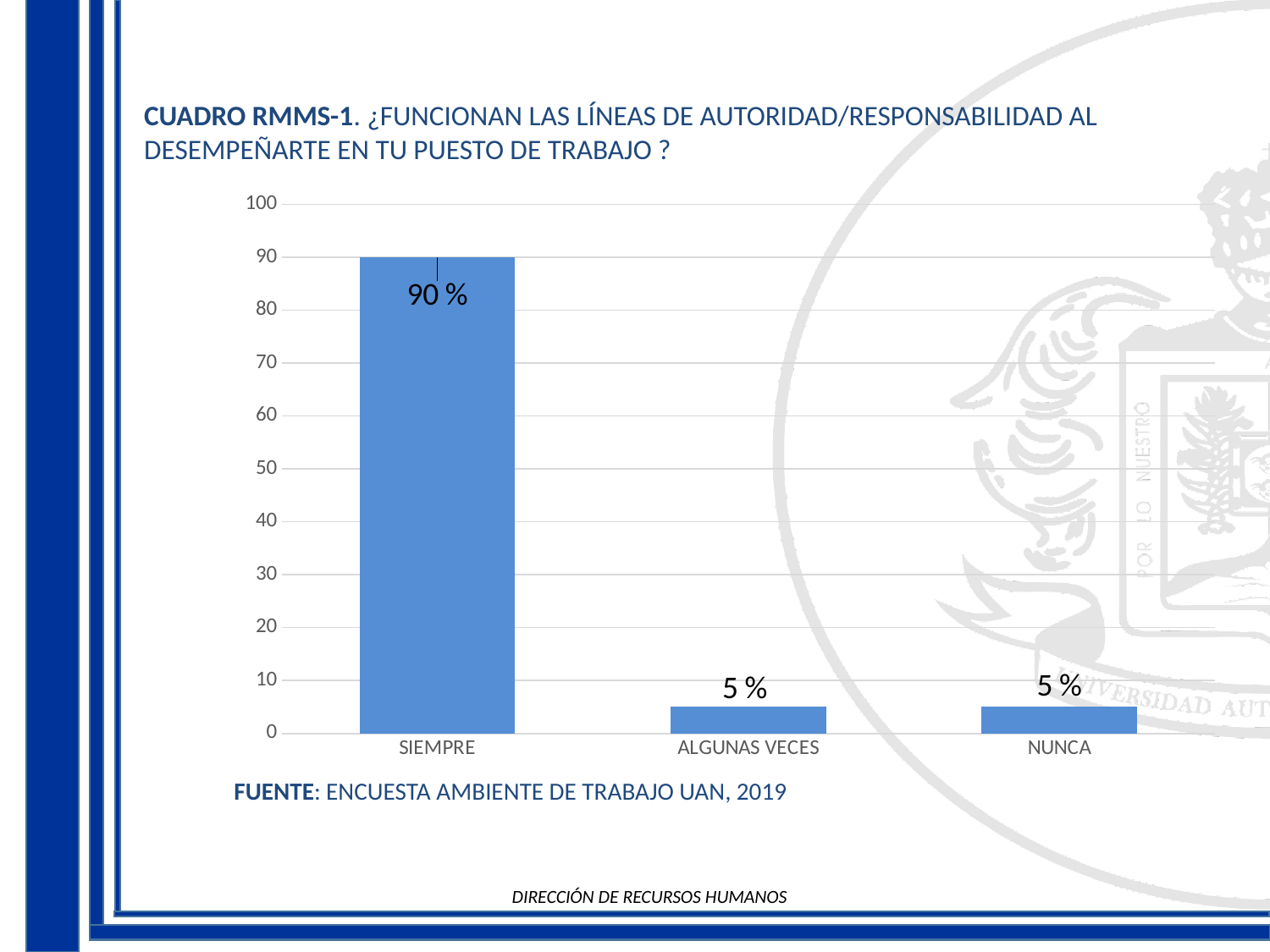
How many categories are shown on the x axis? 3 Which category has the highest value? SIEMPRE What is the source cited below the chart? ENCUESTA AMBIENTE DE TRABAJO UAN, 2019 What is the difference between the values for SIEMPRE and ALGUNAS VECES? 85 % Is the value for SIEMPRE greater or less than 50? greater What is the value for ALGUNAS VECES? 5 % What is the value for SIEMPRE? 90 % Is the value for NUNCA greater or less than 10? less What kind of chart is shown on the slide? bar chart What is the value for NUNCA? 5 % Which is larger, the value for SIEMPRE or the value for NUNCA? SIEMPRE What is the maximum value shown on the y axis? 100